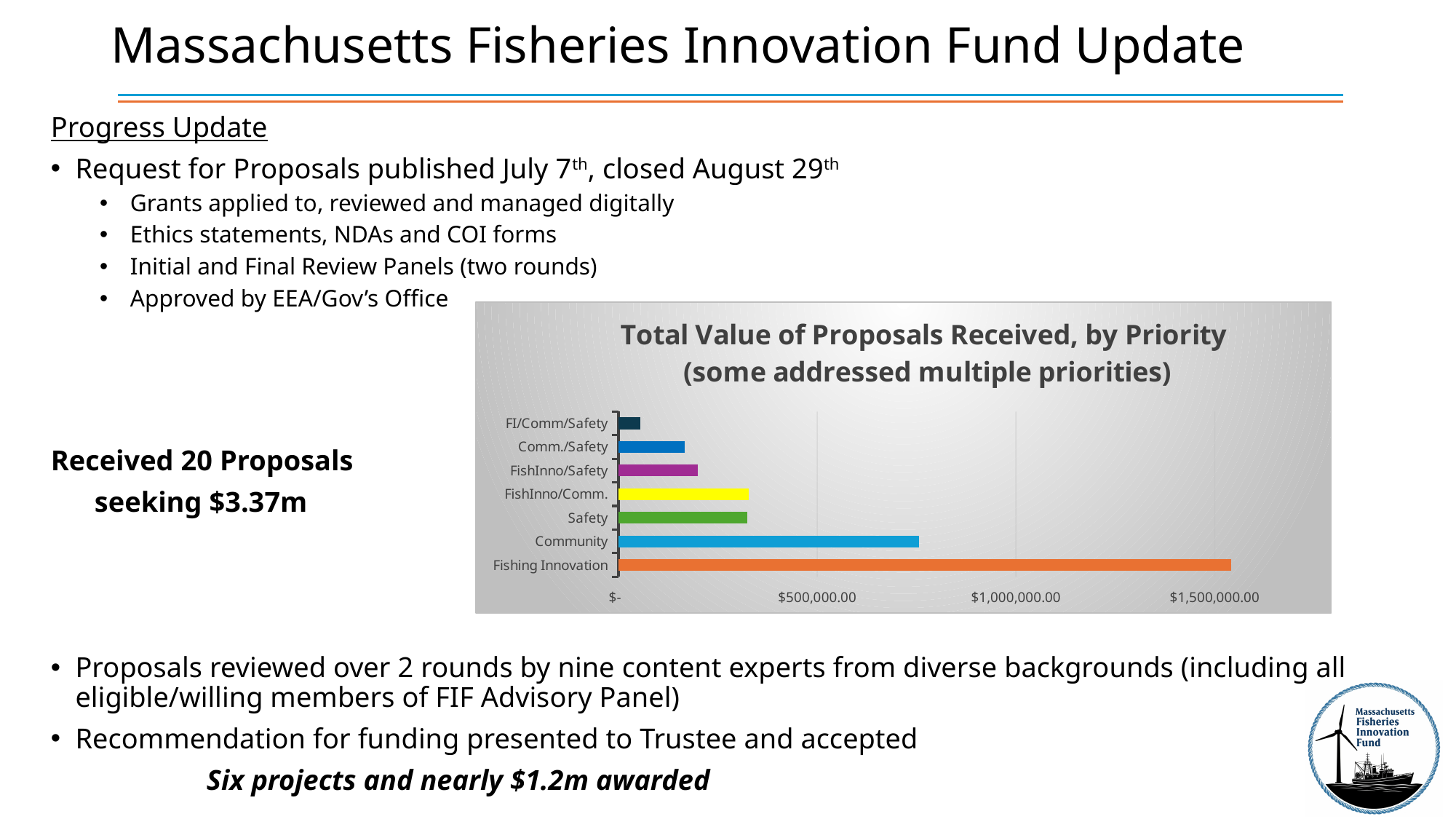
Which priority category has the highest total value of proposals received? Fishing Innovation Which priority category has the lowest total value of proposals received? FI/Comm/Safety Which has a larger total value of proposals, Community or Safety? Community Is the value for Community greater or less than $1,000,000.00? less Is the value for Community greater or less than $500,000.00? greater What is the title of the chart? Total Value of Proposals Received, by Priority (some addressed multiple priorities) Which has a larger total value of proposals, FishInno/Safety or FI/Comm/Safety? FishInno/Safety What colour is the bar for Fishing Innovation? orange Is the value for Safety greater or less than $500,000.00? less How many priority categories are plotted in the chart? 7 What kind of chart is shown on the slide? bar chart